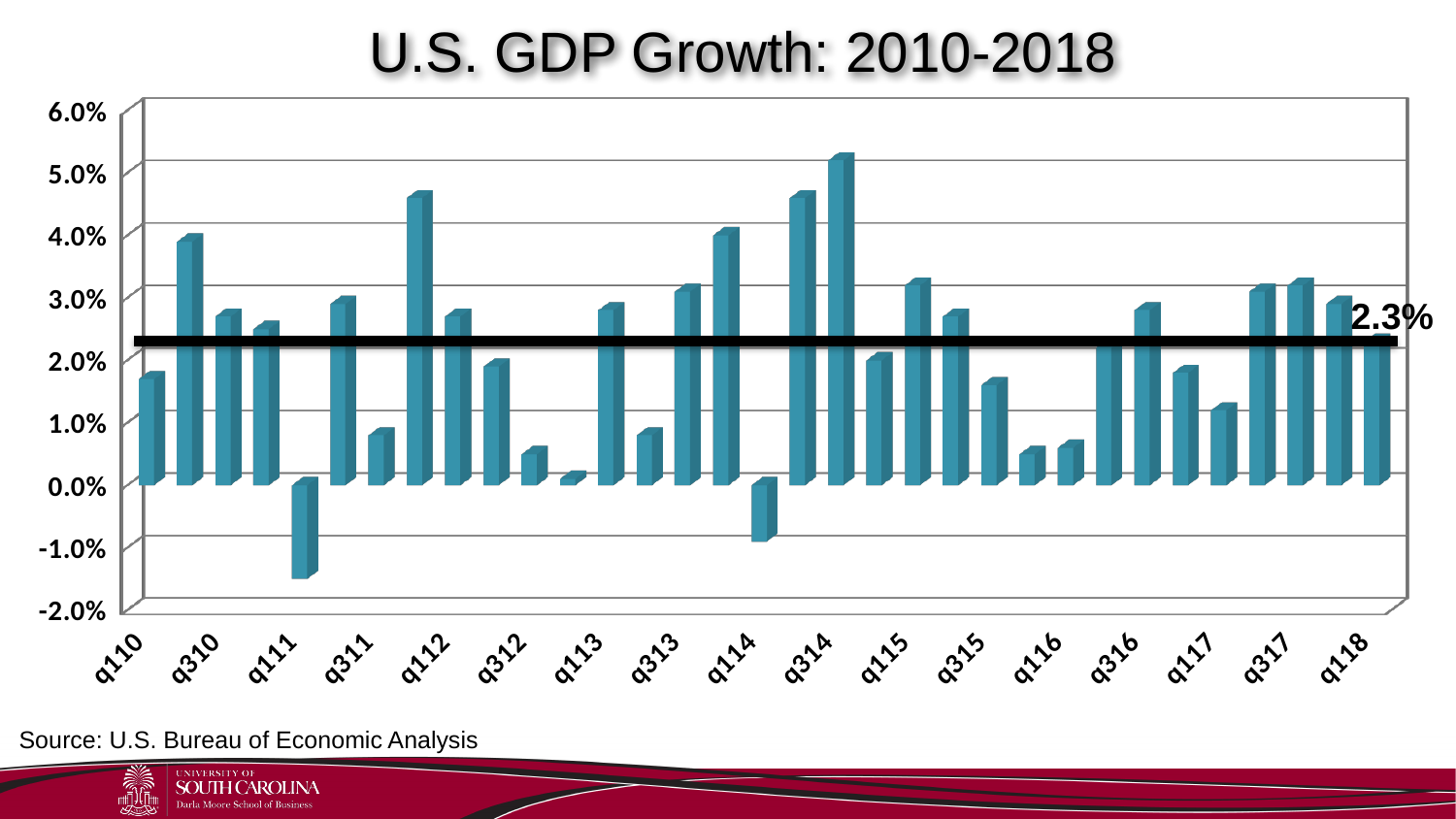
Is the value for q112 greater or less than 4.0%? less Which is larger, the value for q112 or the value for q312? q112 Which labeled quarter has the highest GDP growth? q314 What value is labeled on the horizontal black line drawn across the chart? 2.3% What kind of chart is shown on the slide? bar chart Is the value for q111 greater or less than 0.0%? less Is the value for q310 greater or less than 3.0%? less How many quarter labels are shown on the x axis? 17 Which is larger, the value for q310 or the value for q110? q310 Which labeled quarter has the lowest GDP growth? q111 What is the title of the chart? U.S. GDP Growth: 2010-2018